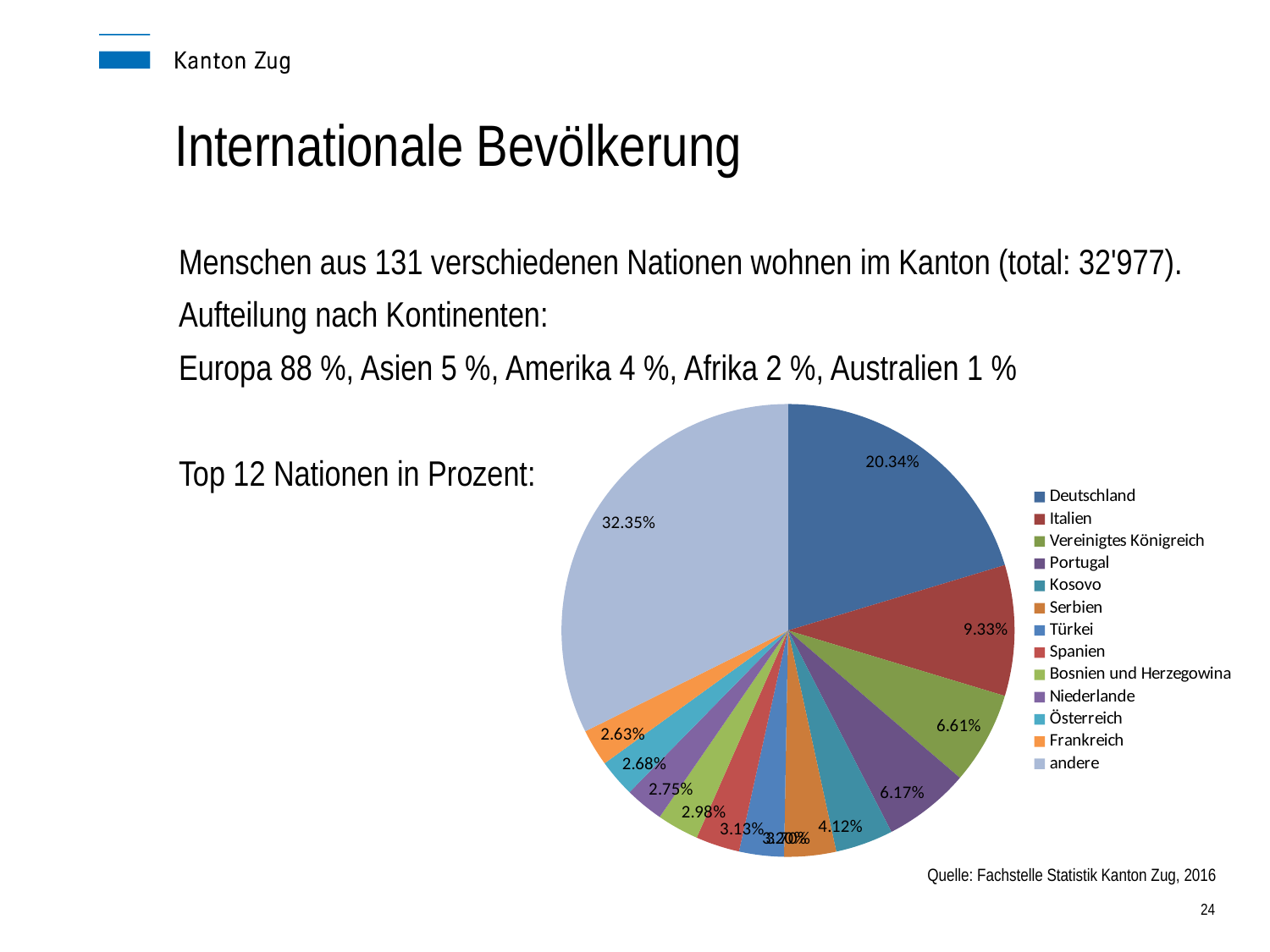
Which named nation has the largest slice in the pie chart? Deutschland What percentage does the pie chart show for Italien? 9.33% By how many percentage points is the Deutschland slice larger than the Italien slice? 11.01 percentage points What percentage does the pie chart show for Vereinigtes Königreich? 6.61% Which legend entry has the largest slice in the pie chart? andere What percentage does the pie chart show for the slice labelled 'andere'? 32.35% How many entries does the legend of the pie chart list? 13 Which slice is larger in the pie chart, Portugal or Kosovo? Portugal What kind of chart is shown on the slide? pie chart What percentage does the pie chart show for Deutschland? 20.34% What percentage does the pie chart show for Kosovo? 4.12% Which legend entry has the smallest slice in the pie chart? Frankreich